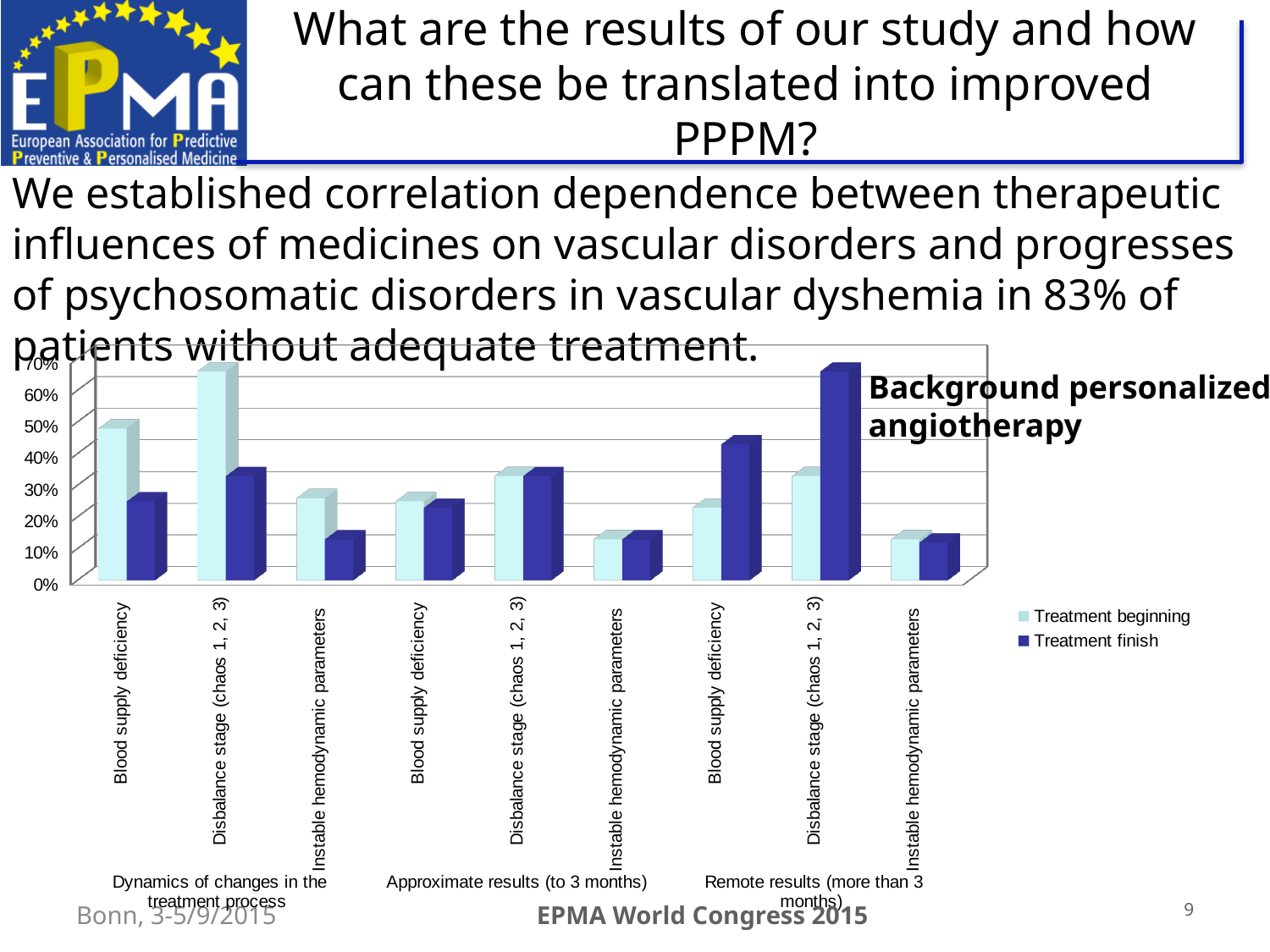
What kind of chart is shown on the slide? bar chart Is the Treatment beginning value for Blood supply deficiency in the Dynamics of changes in the treatment process group greater or less than 40%? greater Into how many labelled groups are the categories on the x axis divided? 3 What are the two series named in the legend? Treatment beginning and Treatment finish For Blood supply deficiency in the Dynamics of changes in the treatment process group, which is larger: Treatment beginning or Treatment finish? Treatment beginning How many categories are plotted along the x axis of the chart? 9 How many series does the chart legend list? 2 For Blood supply deficiency in the Remote results (more than 3 months) group, which is larger: Treatment beginning or Treatment finish? Treatment finish For the Treatment finish series, which category has the highest bar? Disbalance stage (chaos 1, 2, 3) under Remote results (more than 3 months) For the Treatment beginning series, which category has the highest bar? Disbalance stage (chaos 1, 2, 3) under Dynamics of changes in the treatment process Is the Treatment finish value for Disbalance stage (chaos 1, 2, 3) in the Remote results (more than 3 months) group greater or less than 60%? greater Is the Treatment finish value for Instable hemodynamic parameters in the Dynamics of changes in the treatment process group greater or less than 20%? less